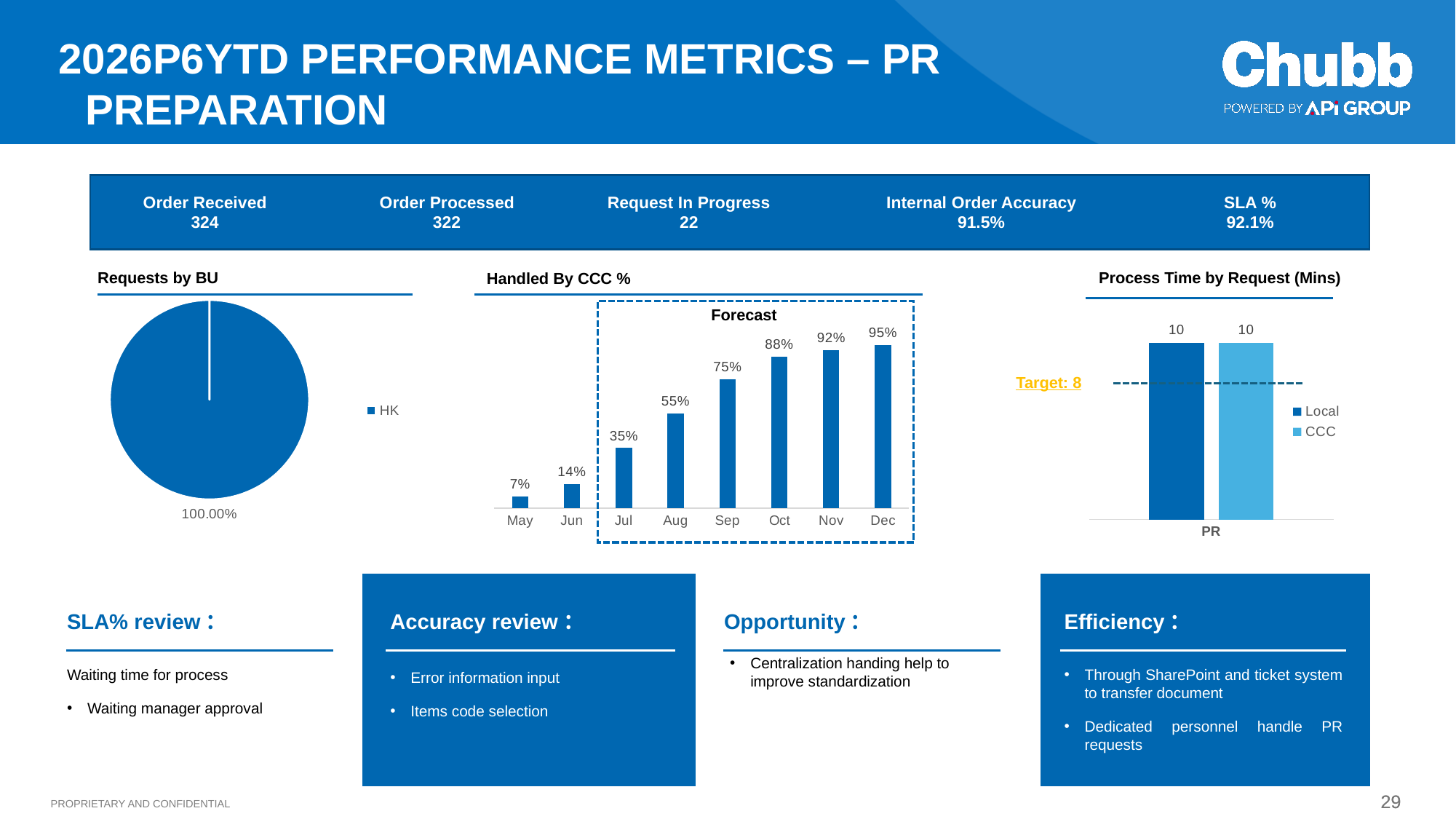
In the 'Handled By CCC %' chart, which month has the highest value? Dec In the 'Handled By CCC %' chart, which month has the lowest value? May How many months are shown on the x axis of the 'Handled By CCC %' chart? 8 In the 'Process Time by Request (Mins)' chart, what is the value for Local? 10 In the 'Handled By CCC %' chart, do the values rise or fall from May to Dec? rise What kind of chart is 'Requests by BU'? pie chart In the 'Requests by BU' pie chart, what share does HK have? 100.00% How many series does the legend of the 'Process Time by Request (Mins)' chart list? 2 In the 'Handled By CCC %' chart, what is the value for May? 7% In the 'Handled By CCC %' chart, what is the difference between the values for Sep and Jul? 40% In the 'Handled By CCC %' chart, what is the value for Aug? 55% What target value is marked on the 'Process Time by Request (Mins)' chart? 8